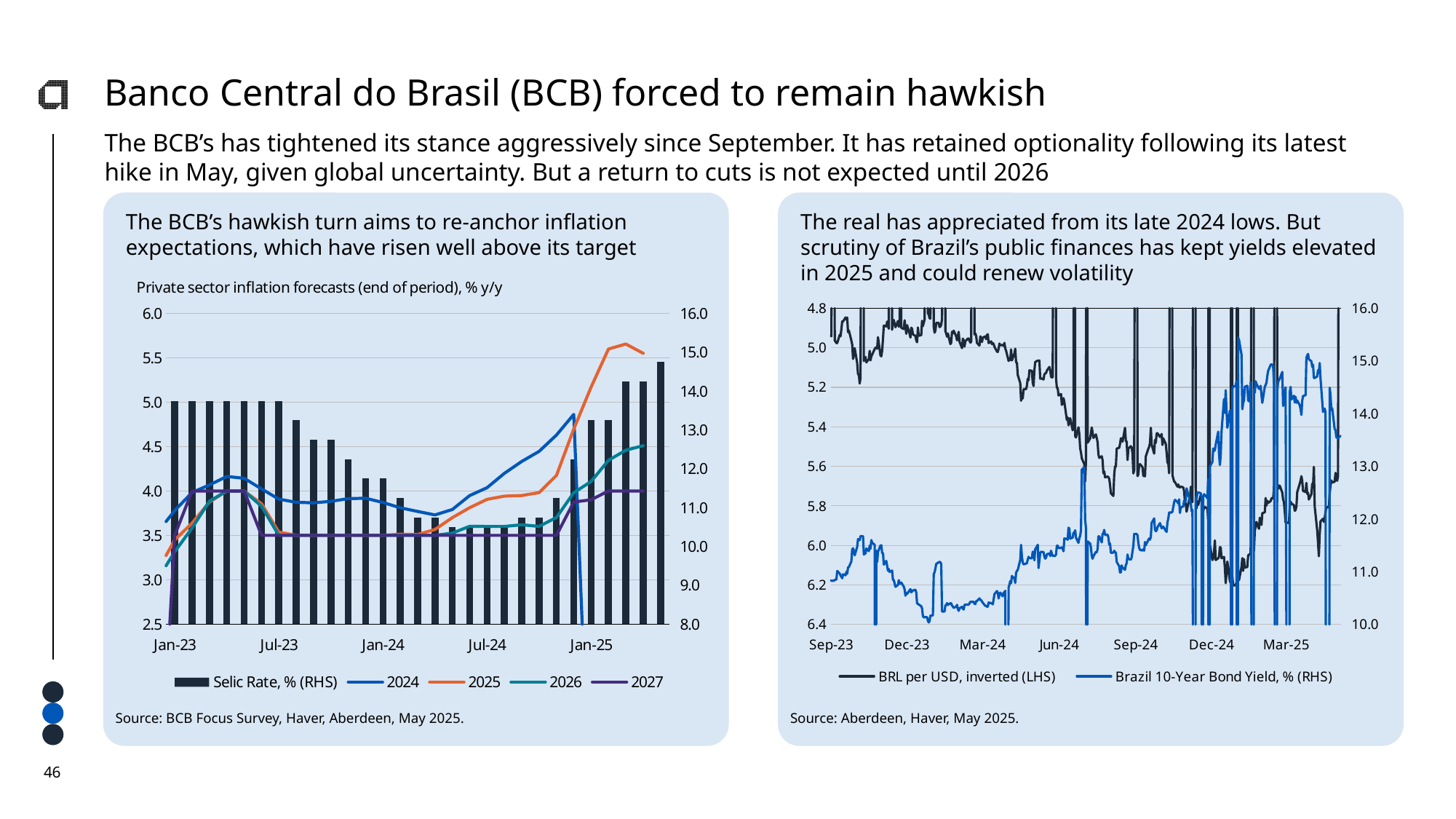
On the left chart, is the Selic Rate bar at Jan-24 greater or less than 12.0 on the right axis? less On the left chart, how many series does the legend list? 5 What kind of chart is the right chart? Line chart On the left chart, is the Selic Rate bar at Jan-25 greater or less than 12.0 on the right axis? greater On the left chart, does the 2025 forecast line rise or fall between Jul-24 and Jan-25? Rise On the right chart, how many series does the legend list? 2 On the left chart, which series is plotted as bars? Selic Rate, % (RHS) On the right chart, is the Brazil 10-Year Bond Yield at Sep-23 greater or less than 12.0? less What is the subtitle printed above the left chart's plot area? Private sector inflation forecasts (end of period), % y/y On the right chart, does the Brazil 10-Year Bond Yield generally rise or fall from Sep-23 to Mar-25? Rise